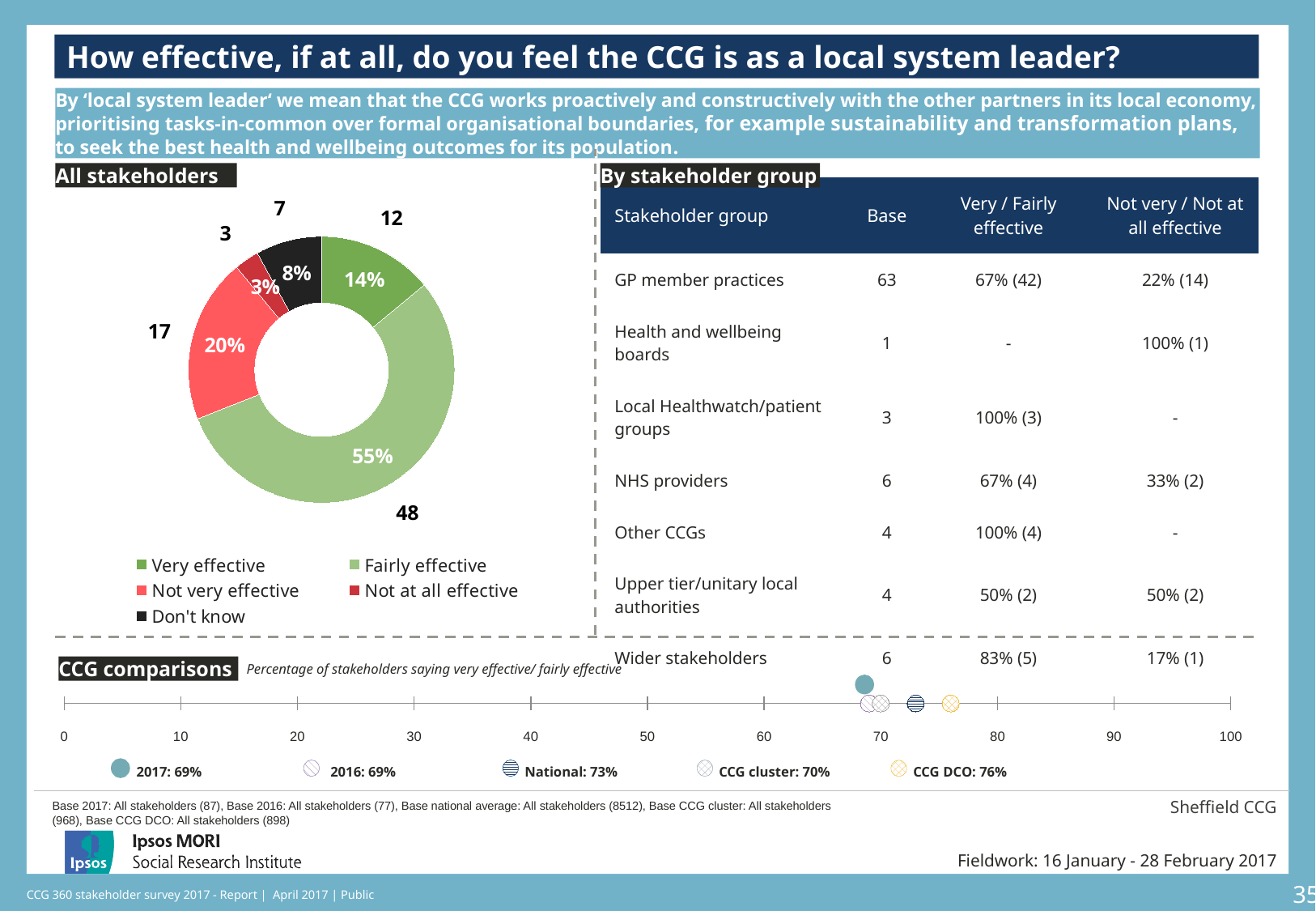
In the 'CCG comparisons' chart, what is the difference between the National value and the 2017 value? 4 percentage points In the 'All stakeholders' donut chart, what is the difference in percentage points between 'Fairly effective' and 'Not very effective'? 35 In the 'CCG comparisons' chart, what is the CCG DCO value? 76% In the 'CCG comparisons' chart, what is the 2017 percentage of stakeholders saying very/fairly effective? 69% How many response categories does the legend of the 'All stakeholders' donut chart list? 5 In the 'All stakeholders' donut chart, which is larger: the share for 'Don't know' or the share for 'Not at all effective'? Don't know In the 'All stakeholders' donut chart, which response category has the largest share? Fairly effective In the 'All stakeholders' donut chart, what percentage of stakeholders said the CCG is fairly effective? 55% In the 'All stakeholders' donut chart, how many stakeholders said 'Not very effective'? 17 What type of chart is used for the 'All stakeholders' section? Donut (pie) chart In the 'All stakeholders' donut chart, what percentage said 'Very effective'? 14% In the 'All stakeholders' donut chart, which response category has the smallest share? Not at all effective